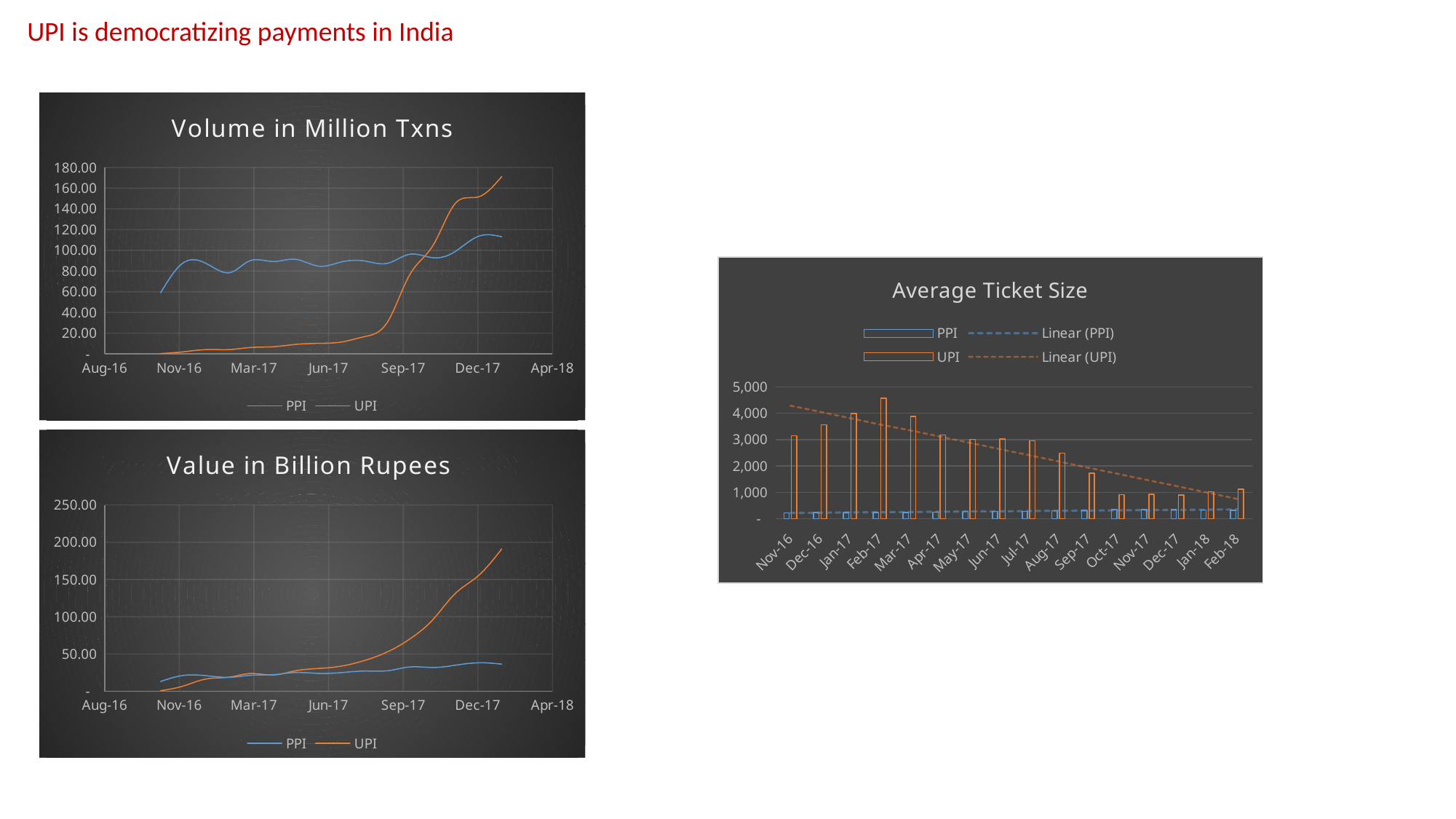
In the 'Volume in Million Txns' chart, which series is higher at Mar-17, PPI or UPI? PPI What kind of chart is the 'Average Ticket Size' chart? bar chart What kind of chart is the 'Volume in Million Txns' chart? line chart In the 'Value in Billion Rupees' chart, is the UPI value at Dec-17 greater or less than 150.00? less In the 'Volume in Million Txns' chart, how many series does the legend list? 2 In the 'Average Ticket Size' chart, how many months are shown on the x axis? 16 In the 'Volume in Million Txns' chart, is the UPI value at Dec-17 greater or less than 140.00? greater In the 'Volume in Million Txns' chart, is the UPI value at Jun-17 greater or less than 20.00? less In the 'Average Ticket Size' chart, which month has the highest UPI bar? Feb-17 In the 'Volume in Million Txns' chart, does the UPI line generally rise or fall from Nov-16 to Dec-17? rise In the 'Value in Billion Rupees' chart, which series is higher at Dec-17, PPI or UPI? UPI